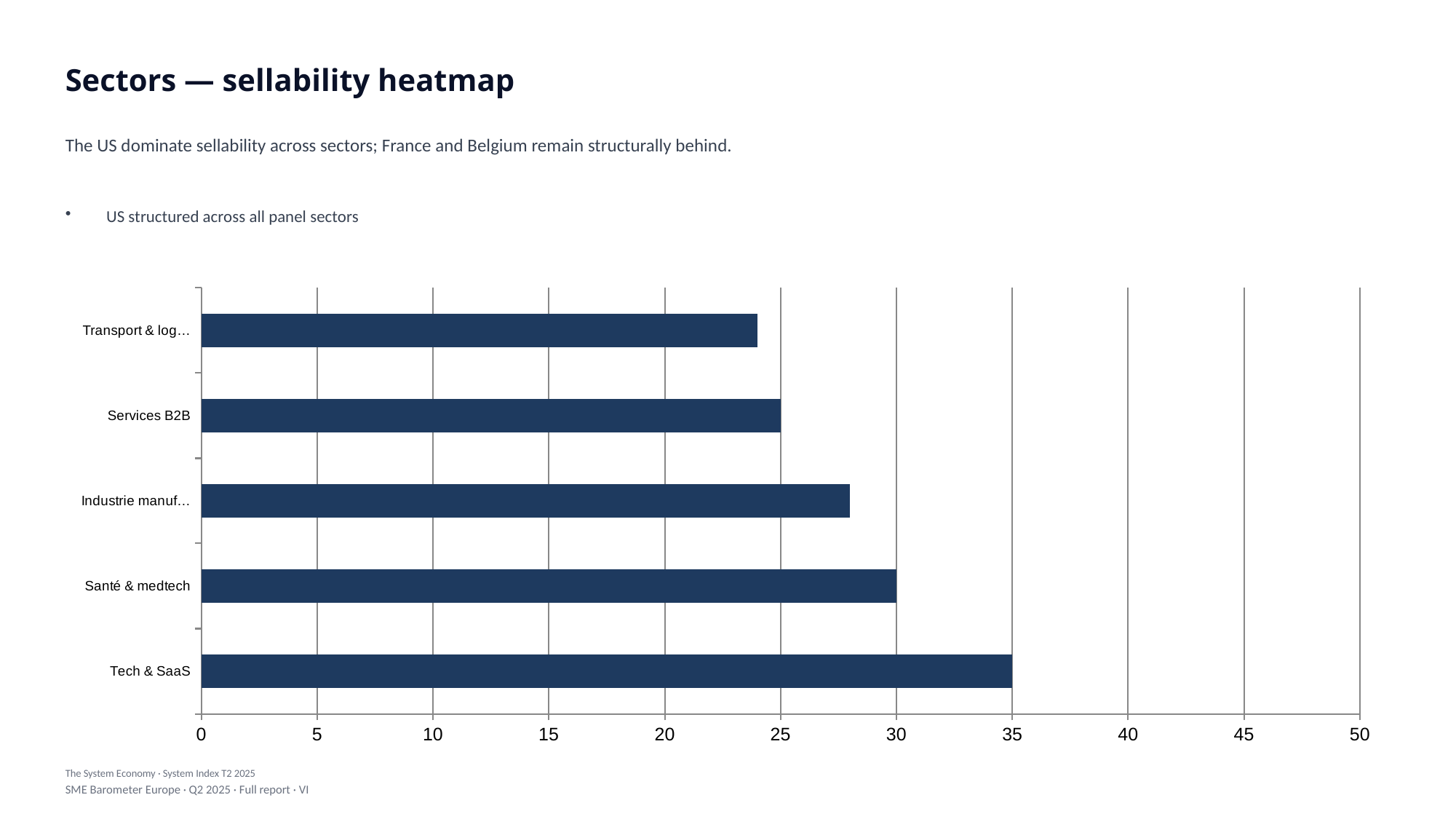
What kind of chart is shown on the slide? bar chart Is the value for Transport & log… greater or less than 25? less What is the value for Services B2B? 25 What is the difference between the values for Tech & SaaS and Santé & medtech? 5 What is the difference between the values for Tech & SaaS and Services B2B? 10 Which sector has the lowest value? Transport & log… What is the value for Tech & SaaS? 35 How many sectors are plotted in the chart? 5 Which sector has the highest value? Tech & SaaS Which is larger, the value for Industrie manuf… or the value for Services B2B? Industrie manuf… What is the value for Santé & medtech? 30 Is the value for Industrie manuf… greater or less than 30? less